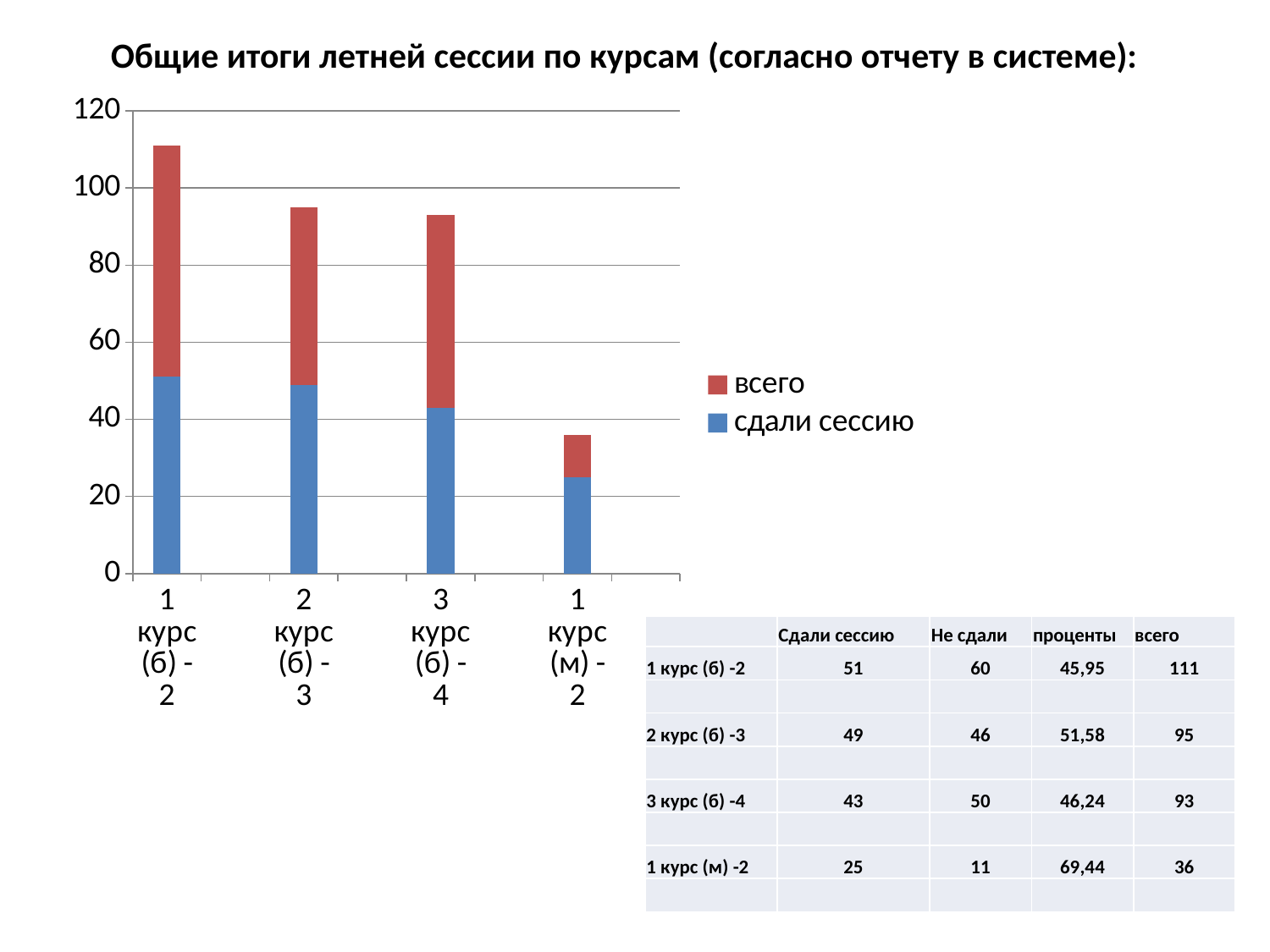
Is the total height of the bar for 1 курс (б) - 2 greater or less than 100? greater How many series does the chart legend list? 2 Which category has the shortest stacked bar in the chart? 1 курс (м) - 2 According to the table on the slide, what is the 'всего' value for 3 курс (б) -4? 93 Is the blue 'сдали сессию' segment for 3 курс (б) - 4 greater or less than 60? less According to the table on the slide, how many students in 1 курс (б) -2 passed the session (Сдали сессию)? 51 How many categories (courses) are shown on the x axis of the chart? 4 Which category has the tallest stacked bar in the chart? 1 курс (б) - 2 What kind of chart is shown on the slide? stacked bar chart Which bar is taller in the chart: 2 курс (б) - 3 or 1 курс (м) - 2? 2 курс (б) - 3 Which series is shown in blue in the chart? сдали сессию Is the total height of the bar for 1 курс (м) - 2 greater or less than 40? less